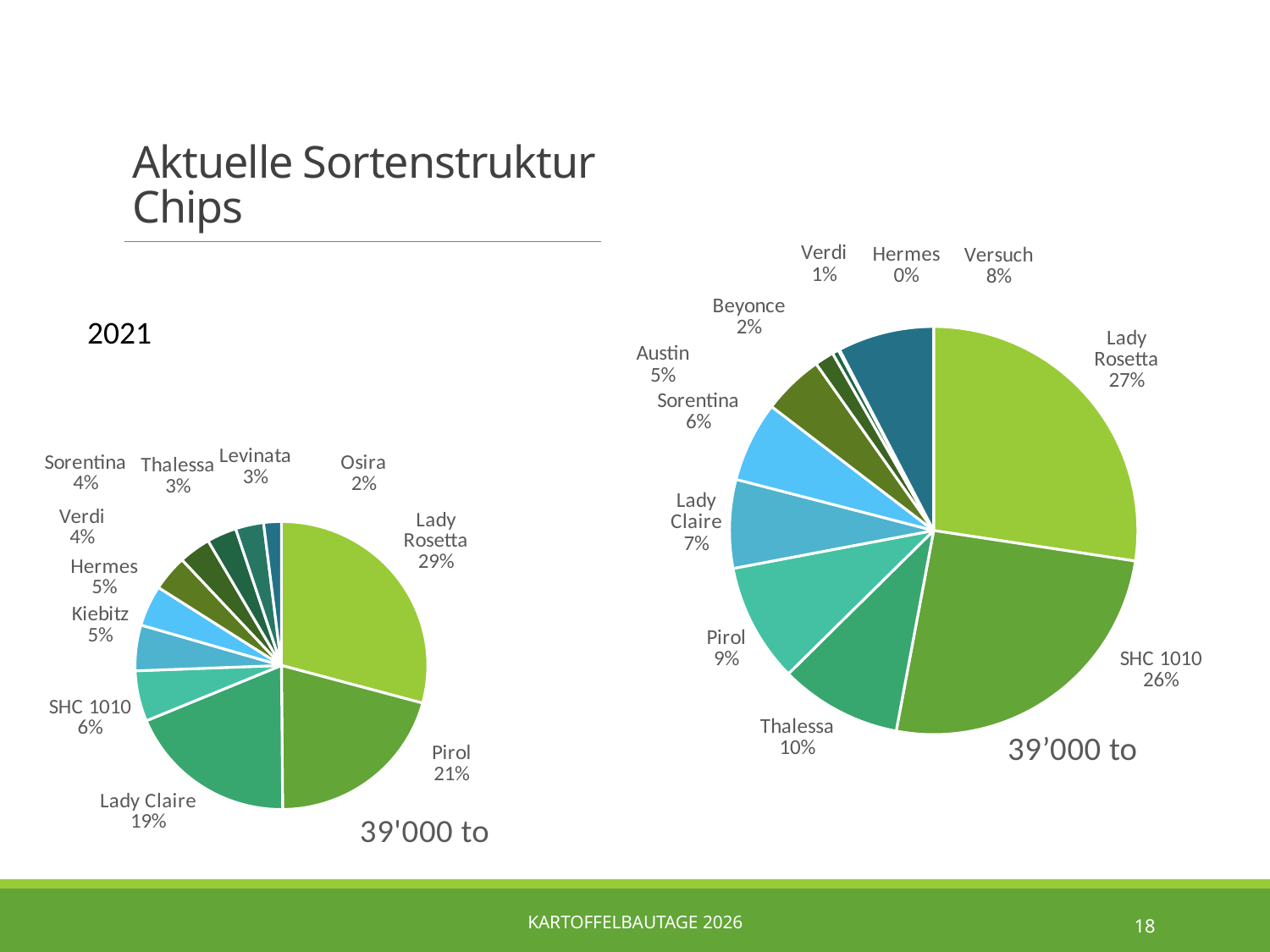
What kind of chart is used on the right side of the slide? Pie chart In the right pie chart, which is larger, the share of Pirol or the share of Lady Claire? Pirol In the left pie chart (2021), what is the difference between the shares of Pirol and Lady Claire? 2% In the left pie chart (2021), which variety has the smallest share? Osira In the left pie chart (2021), what share does Lady Rosetta have? 29% In the left pie chart (2021), what share does Lady Claire have? 19% How many slices does the left pie chart (2021) have? 11 In the right pie chart, what share does Thalessa have? 10% What total quantity is printed below the right pie chart? 39'000 to In the right pie chart, what share does SHC 1010 have? 26% In the right pie chart, which variety has the smallest share? Hermes In the right pie chart, which variety has the largest share? Lady Rosetta